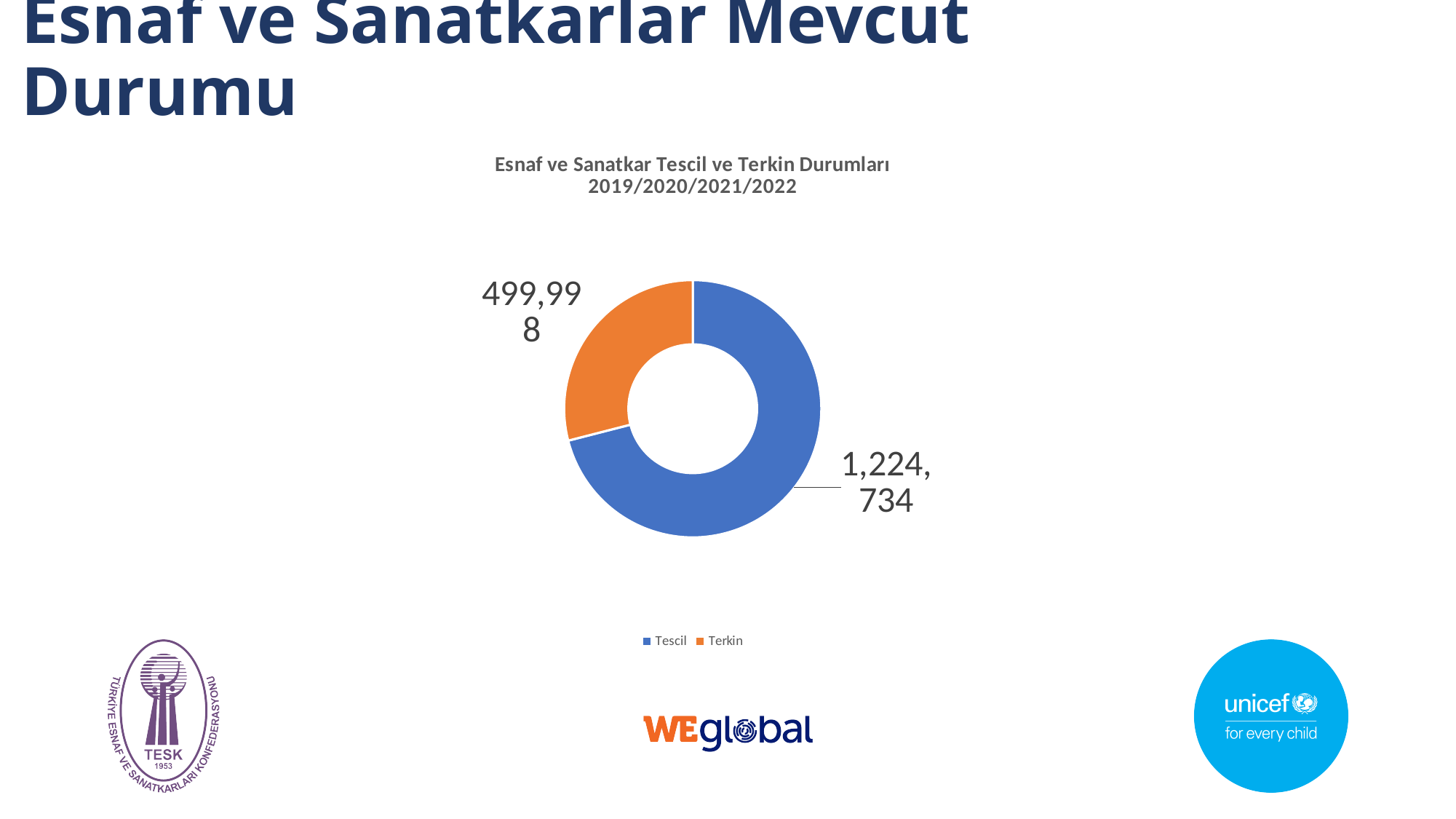
Which category has the largest slice in the chart? Tescil What is the difference between the Tescil and Terkin values? 724,736 What kind of chart is shown on the slide? Doughnut (pie) chart What is the total of the two values shown in the chart? 1,724,732 What is the value for Tescil in the chart? 1,224,734 How many categories are shown in the chart? 2 What colour is the Terkin slice in the chart? Orange How many entries does the legend list? 2 Which is larger, Tescil or Terkin? Tescil What is the value for Terkin in the chart? 499,998 Which category has the smallest slice in the chart? Terkin